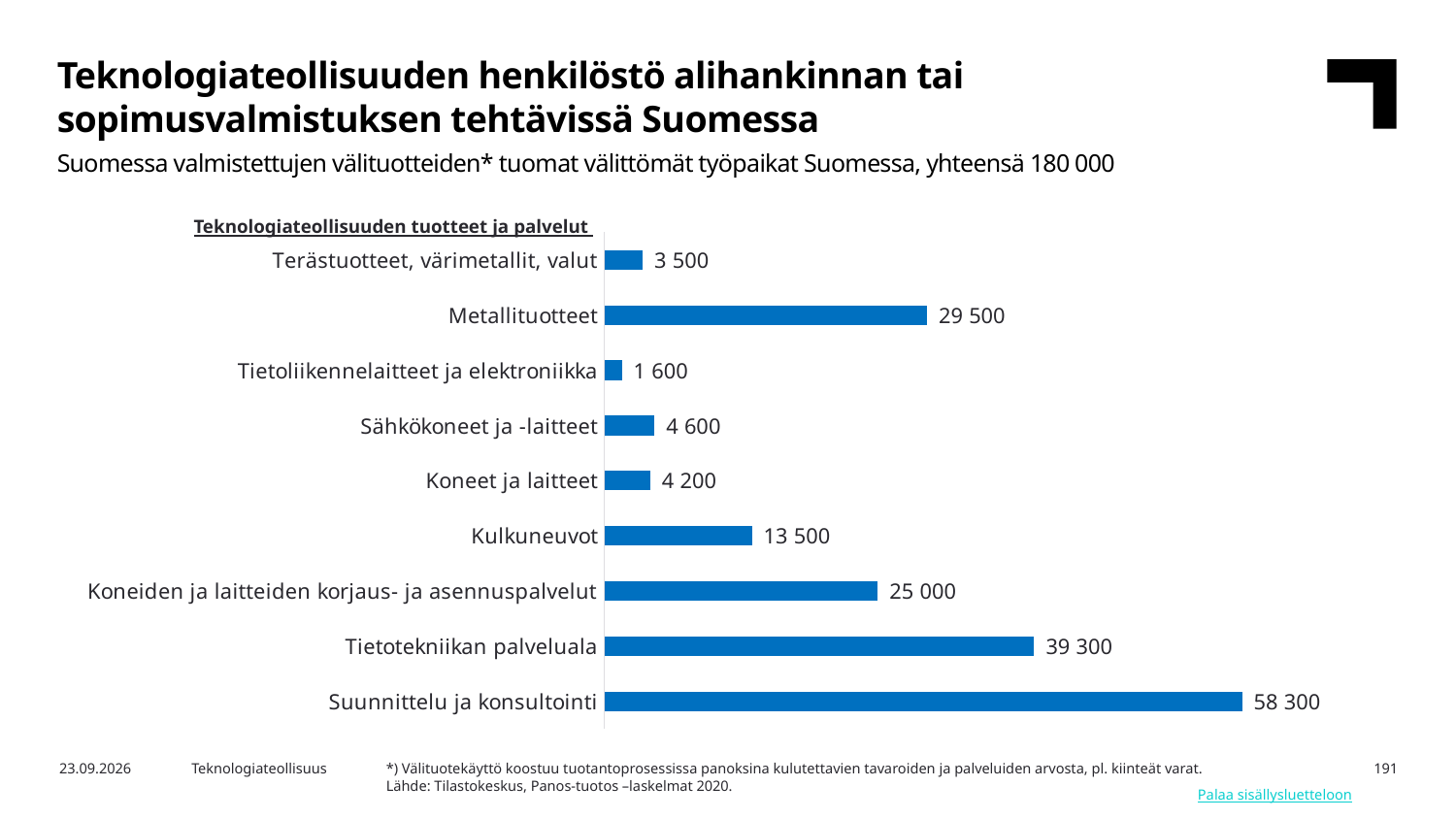
Which category has the lowest value? Tietoliikennelaitteet ja elektroniikka Which is larger, Kulkuneuvot or Terästuotteet, värimetallit, valut? Kulkuneuvot Which category has the highest value? Suunnittelu ja konsultointi How many categories are shown in the chart? 9 What is the heading printed above the chart's category labels? Teknologiateollisuuden tuotteet ja palvelut What is the value for Metallituotteet? 29 500 What is the difference between Suunnittelu ja konsultointi and Tietotekniikan palveluala? 19 000 What is the value for Kulkuneuvot? 13 500 What kind of chart is shown on the slide? Bar chart What is the difference between Metallituotteet and Koneiden ja laitteiden korjaus- ja asennuspalvelut? 4 500 What is the value for Tietotekniikan palveluala? 39 300 Which is larger, Sähkökoneet ja -laitteet or Koneet ja laitteet? Sähkökoneet ja -laitteet